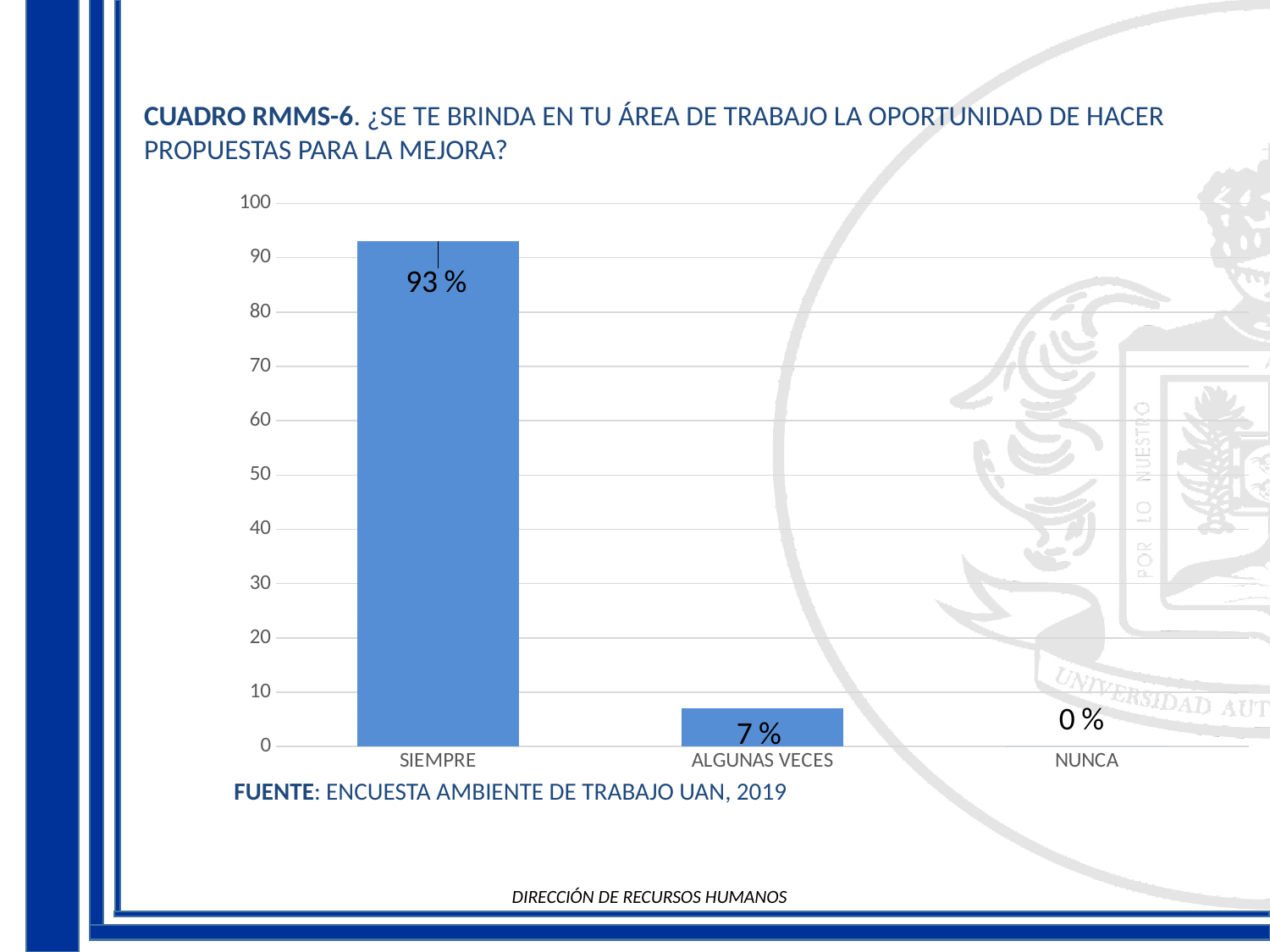
What kind of chart is shown on the slide? bar chart What is the difference between the values for SIEMPRE and ALGUNAS VECES? 86 % Which is larger, the value for ALGUNAS VECES or the value for NUNCA? ALGUNAS VECES Is the value for SIEMPRE greater or less than 90? greater Which category has the highest value? SIEMPRE What source is cited below the chart? ENCUESTA AMBIENTE DE TRABAJO UAN, 2019 Which category has the lowest value? NUNCA How many categories are shown on the x axis? 3 Is the value for ALGUNAS VECES greater or less than 10? less What is the value for ALGUNAS VECES? 7 % What is the value for NUNCA? 0 % What is the value for SIEMPRE? 93 %